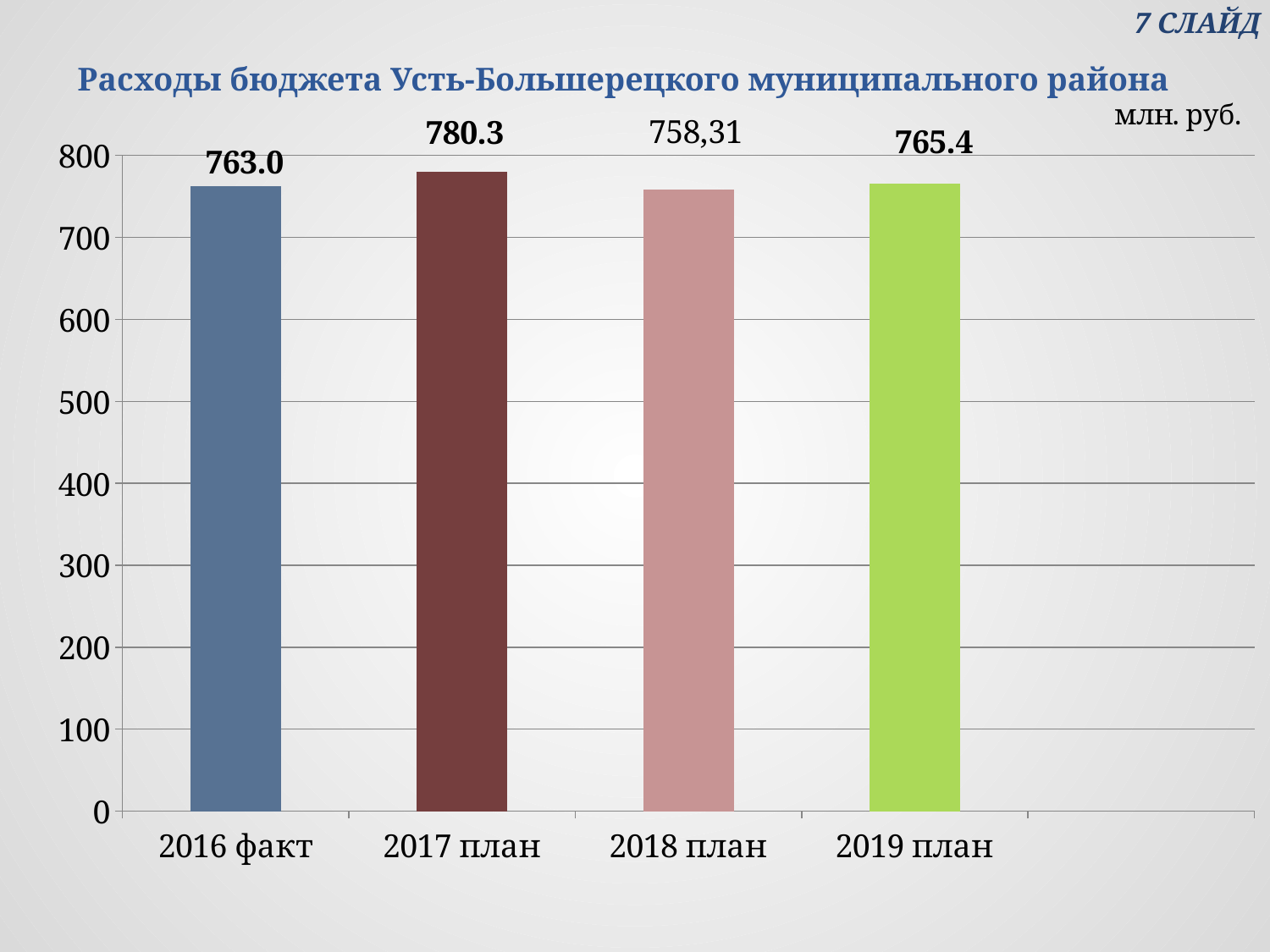
Which is larger, the value for 2019 план or the value for 2016 факт? 2019 план Which category has the lowest value? 2018 план Is the value for 2018 план greater or less than 700? greater Which category has the highest value? 2017 план What is the value for 2017 план? 780.3 What is the value for 2016 факт? 763.0 What is the difference between the values for 2019 план and 2016 факт? 2.4 How many categories are shown on the x axis? 4 What is the difference between the values for 2017 план and 2016 факт? 17.3 What is the value for 2019 план? 765.4 What kind of chart is shown on the slide? bar chart What is the value for 2018 план? 758,31